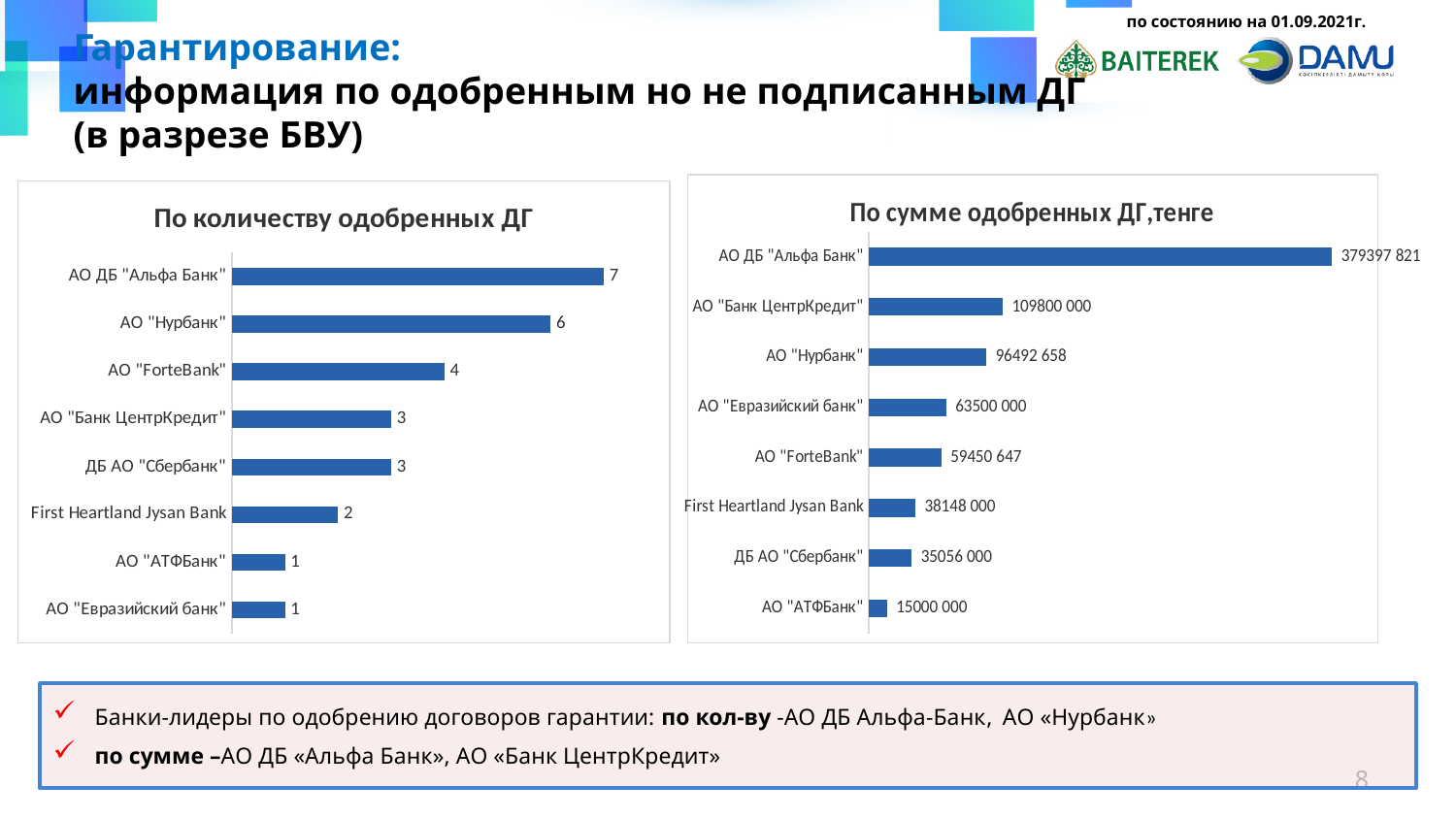
In the chart "По количеству одобренных ДГ", which bank has the highest value? АО ДБ "Альфа Банк" In the chart "По количеству одобренных ДГ", what is the value for АО "Нурбанк"? 6 In the chart "По сумме одобренных ДГ,тенге", what is the value for АО "Евразийский банк"? 63500 000 In the chart "По сумме одобренных ДГ,тенге", what is the difference between First Heartland Jysan Bank and ДБ АО "Сбербанк"? 3092 000 In the chart "По количеству одобренных ДГ", how many banks are shown? 8 What is the title of the chart on the left side of the slide? По количеству одобренных ДГ In the chart "По количеству одобренных ДГ", what is the value for First Heartland Jysan Bank? 2 In the chart "По сумме одобренных ДГ,тенге", which bank has the lowest value? АО "АТФБанк" In the chart "По количеству одобренных ДГ", what is the difference between АО ДБ "Альфа Банк" and АО "ForteBank"? 3 What type of chart is "По сумме одобренных ДГ,тенге"? Bar chart In the chart "По сумме одобренных ДГ,тенге", which is larger: the value for АО "Нурбанк" or АО "ForteBank"? АО "Нурбанк" In the chart "По сумме одобренных ДГ,тенге", what is the value for АО "Банк ЦентрКредит"? 109800 000